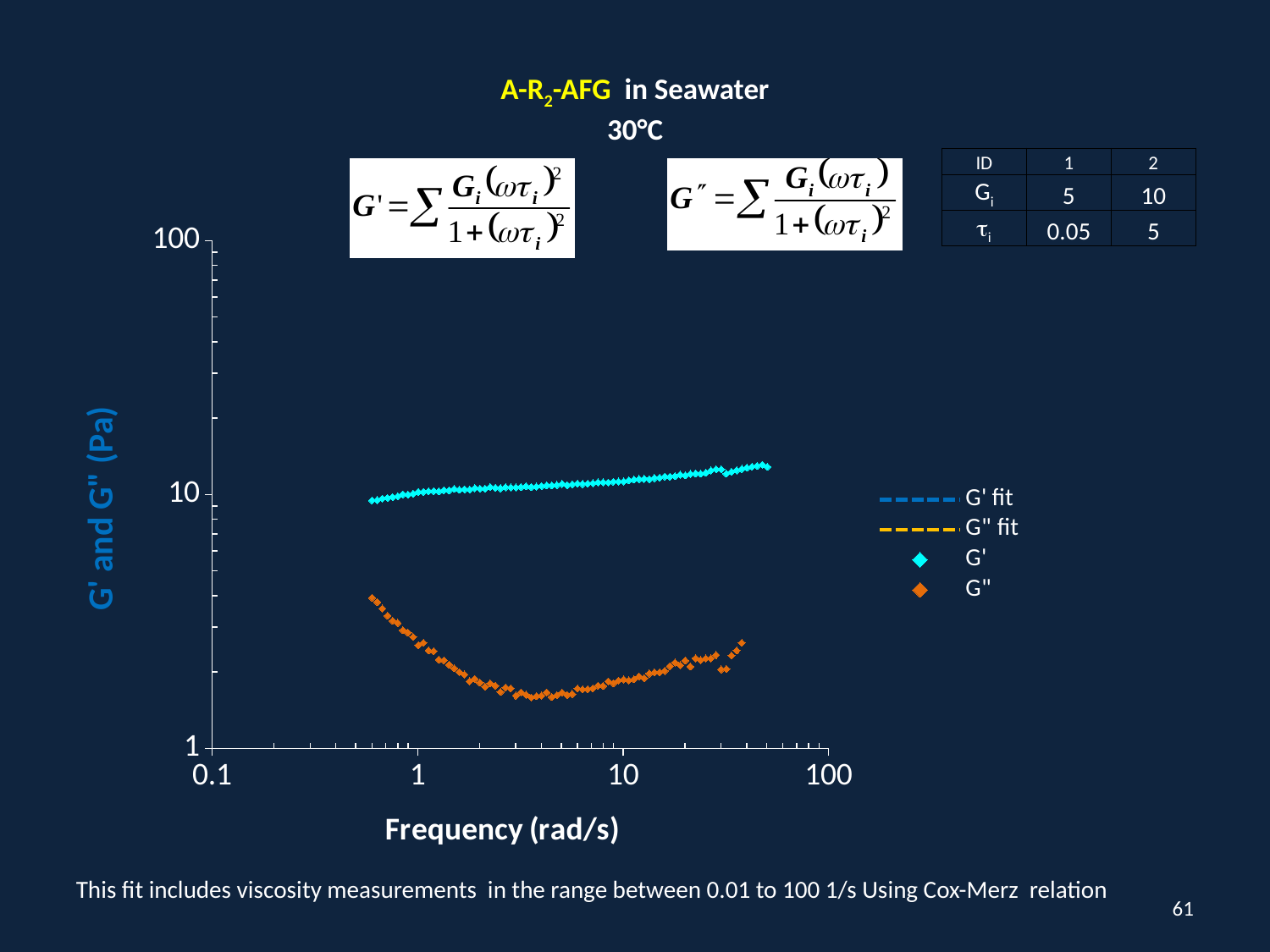
What is the highest value shown on the y axis of the chart? 100 Is the value of G" at a frequency of 10 rad/s greater or less than 1? greater Do the G' values rise or fall as frequency increases along the x axis? rise Is the value of G" at a frequency of 1 rad/s greater or less than 10? less What kind of chart is shown on the slide? scatter chart How many entries does the chart legend list? 4 Is the value of G' at a frequency of 10 rad/s greater or less than 10? greater Which series has the larger values across the plotted frequency range, G' or G"? G' What is the label of the x axis of the chart? Frequency (rad/s) What is the label of the y axis of the chart? G' and G" (Pa) Which series reaches the lowest value on the chart, G' or G"? G"